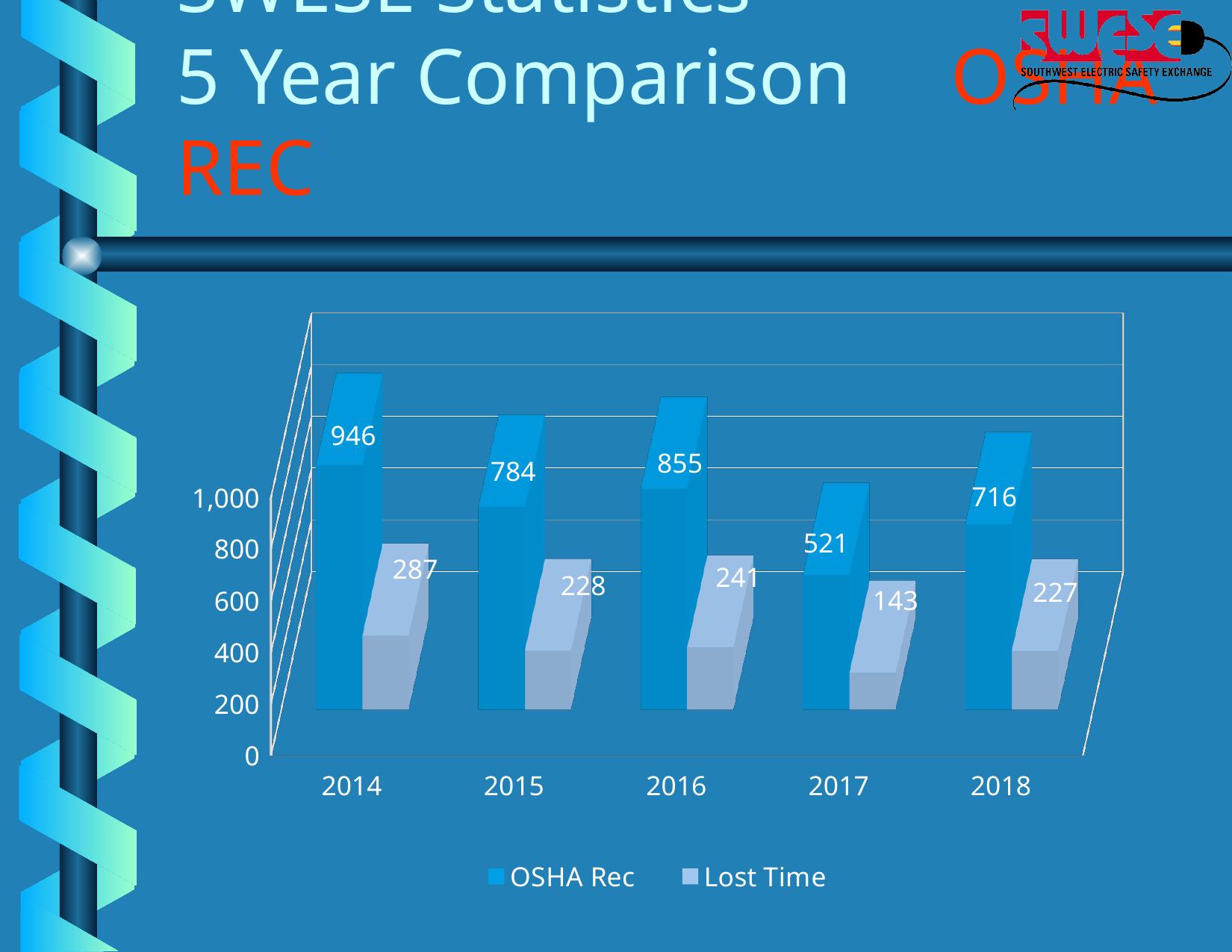
What is the difference between the OSHA Rec values for 2016 and 2017? 334 What kind of chart is shown on the slide? Bar chart How many series does the legend list? 2 What is the OSHA Rec value for 2014? 946 Does the OSHA Rec value rise or fall from 2016 to 2017? Fall Which year has the highest OSHA Rec value? 2014 What are the two series named in the legend? OSHA Rec and Lost Time What is the Lost Time value for 2017? 143 How many years are shown on the x axis? 5 Which year has the lowest Lost Time value? 2017 What is the OSHA Rec value for 2018? 716 Which is larger, the Lost Time value for 2015 or for 2016? 2016